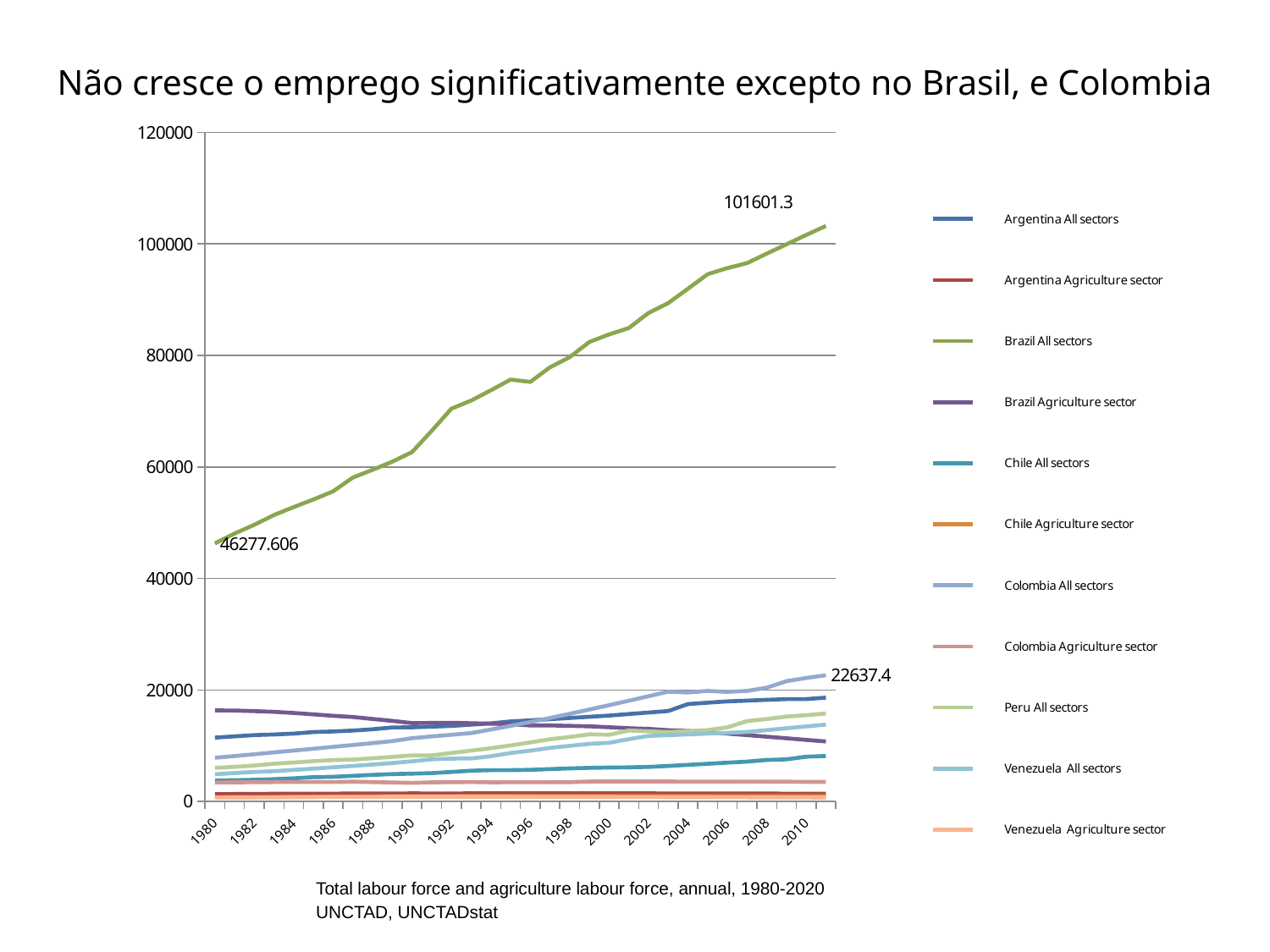
Which series has the highest value at the right end of the chart? Brazil All sectors What is the highest labelled value shown on the Brazil All sectors line? 101601.3 What is the labelled value of the Brazil All sectors series in 1980? 46277.606 Does the Brazil Agriculture sector line rise or fall over the period shown? fall What is the labelled value at the end of the Colombia All sectors line? 22637.4 Is the value for Argentina All sectors in 2010 greater or less than 20000? less Is the value for Brazil All sectors in 2004 greater or less than 80000? greater Does the Brazil All sectors line rise or fall from 1980 to the end of the chart? rise How many series does the legend list? 11 What is the difference between the two labelled values on the Brazil All sectors line, 101601.3 and 46277.606? 55323.694 What kind of chart is shown on the slide? line chart In 1980, which is larger: Argentina All sectors or Chile All sectors? Argentina All sectors